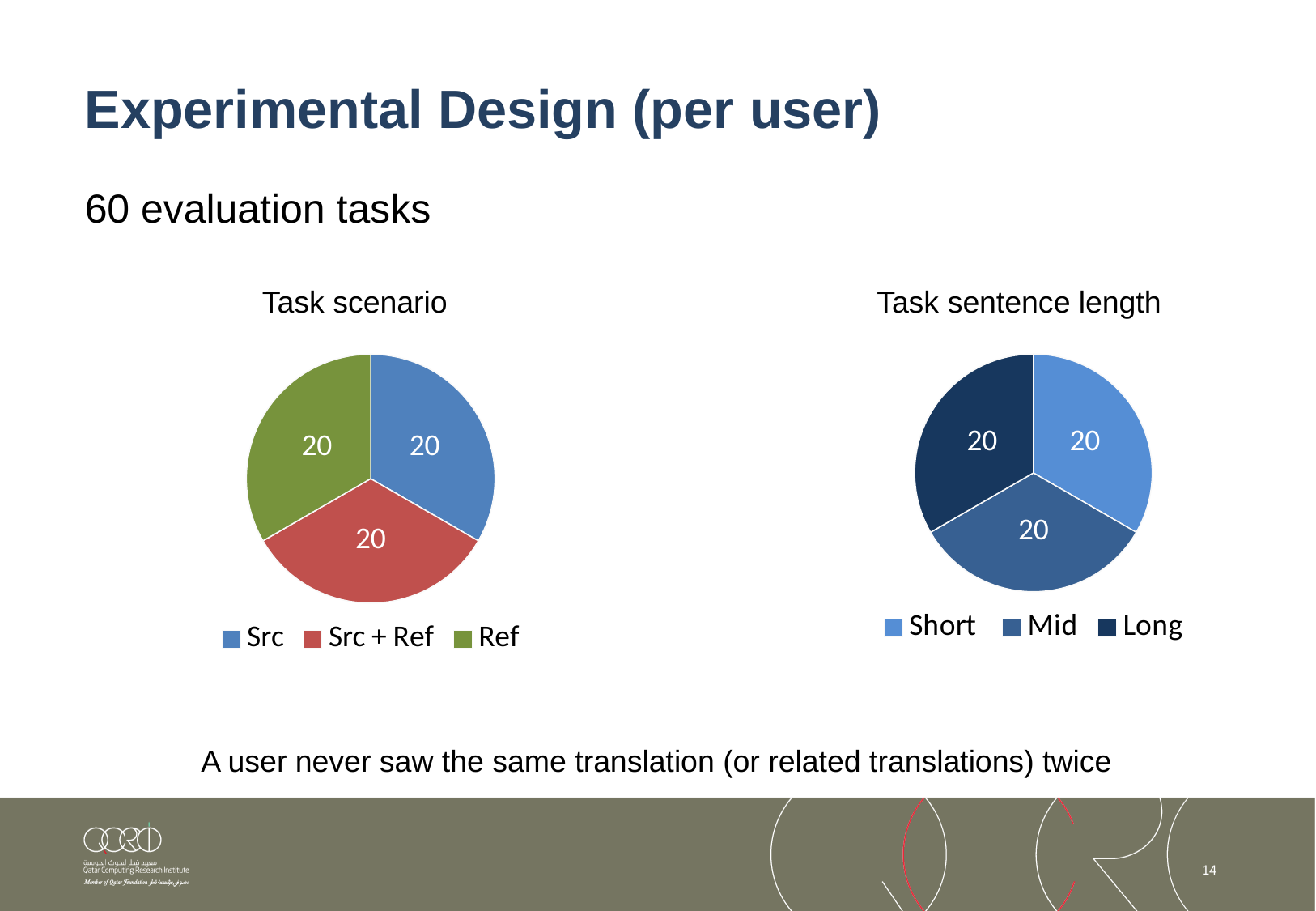
In the Task scenario chart, what is the value for Src + Ref? 20 What kind of chart is the Task scenario chart? pie chart In the Task sentence length chart, what is the value for Mid? 20 In the Task scenario chart, what is the value for Src? 20 In the Task scenario chart, what share of the total does the Ref slice represent? one third In the Task scenario chart, what is the difference between the values for Ref and Src? 0 In the Task sentence length chart, what is the value for Long? 20 In the Task scenario chart, which category is shown in red? Src + Ref What is the title of the pie chart on the right of the slide? Task sentence length How many slices does the Task sentence length chart have? 3 How many categories does the legend of the Task scenario chart list? 3 What is the total of all slices in the Task sentence length chart? 60